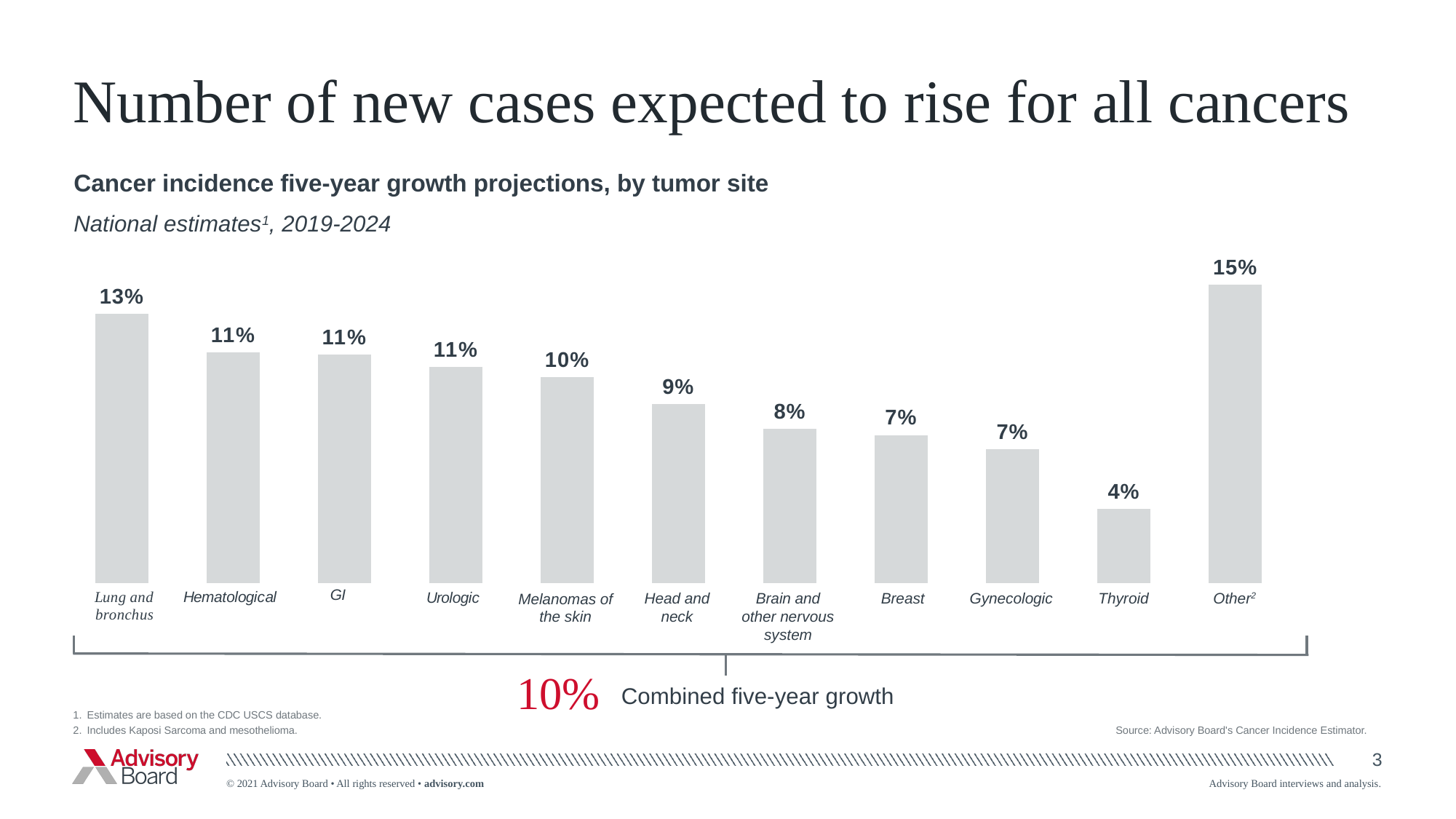
Which tumor site has the lowest projected five-year growth? Thyroid What is the projected five-year growth for Lung and bronchus? 13% What combined five-year growth figure is shown below the chart? 10% What is the projected five-year growth for Melanomas of the skin? 10% What is the difference between the projected growth for Other and for Lung and bronchus? 2% How many tumor site categories are shown in the chart? 11 What type of chart is shown on the slide? Bar chart Which has a higher projected five-year growth, Urologic or Breast? Urologic Which tumor site has the highest projected five-year growth? Other What is the projected five-year growth for Brain and other nervous system? 8% What is the projected five-year growth for Thyroid? 4% What is the difference between the projected growth for Head and neck and for Thyroid? 5%